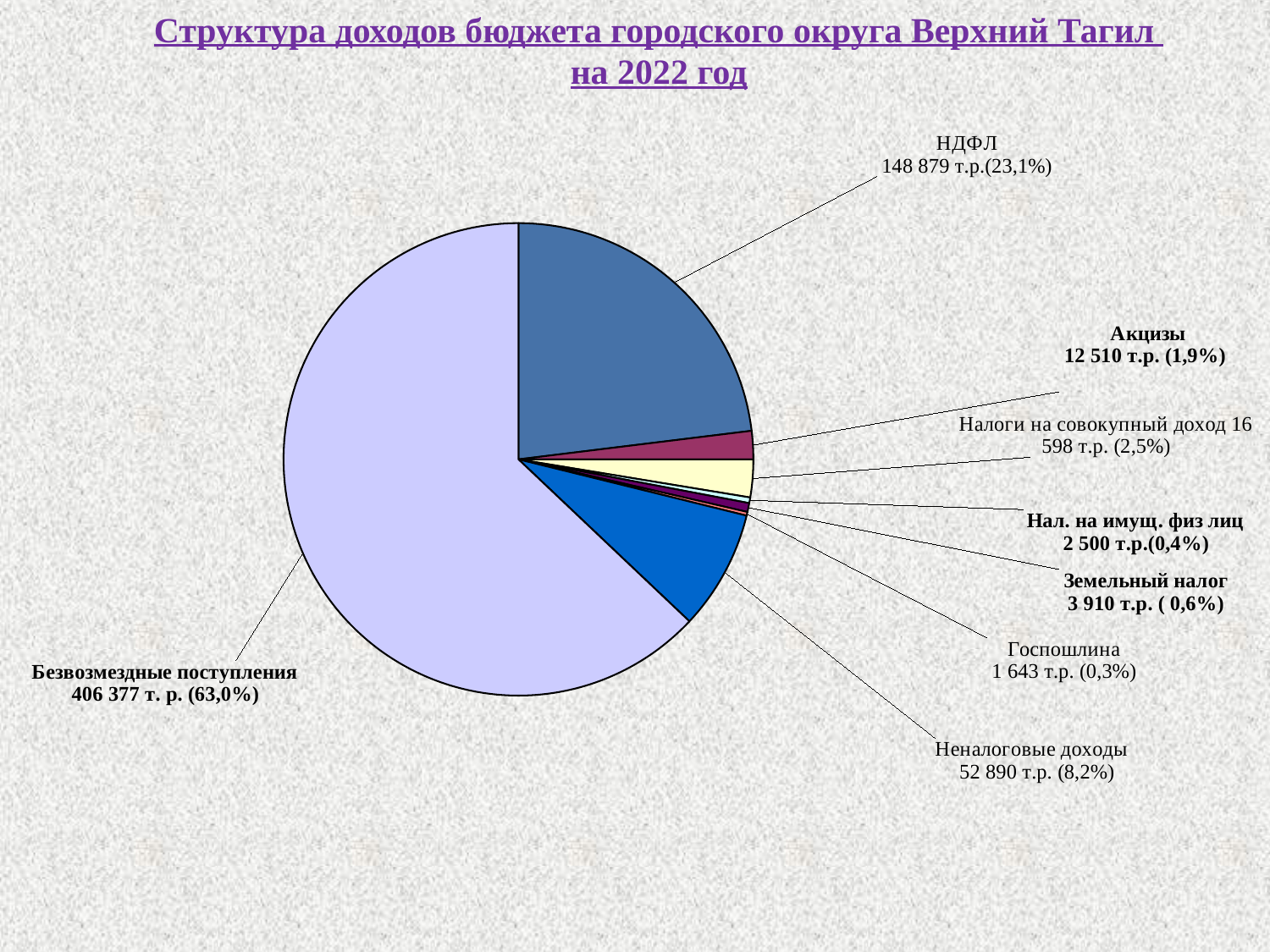
Which is larger, Налоги на совокупный доход or Акцизы? Налоги на совокупный доход How many slices does the pie chart have? 8 What is the value shown for НДФЛ? 148 879 т.р. What share of the pie does Безвозмездные поступления represent? 63,0% What kind of chart is shown on the slide? pie chart What is the title of the chart? Структура доходов бюджета городского округа Верхний Тагил на 2022 год What is the value shown for Акцизы? 12 510 т.р. What is the difference in value between Земельный налог and Нал. на имущ. физ лиц? 1 410 т.р. What share of the pie does Госпошлина represent? 0,3% Which category has the largest slice of the pie? Безвозмездные поступления What share of the pie does Неналоговые доходы represent? 8,2% Which category has the smallest slice of the pie? Госпошлина